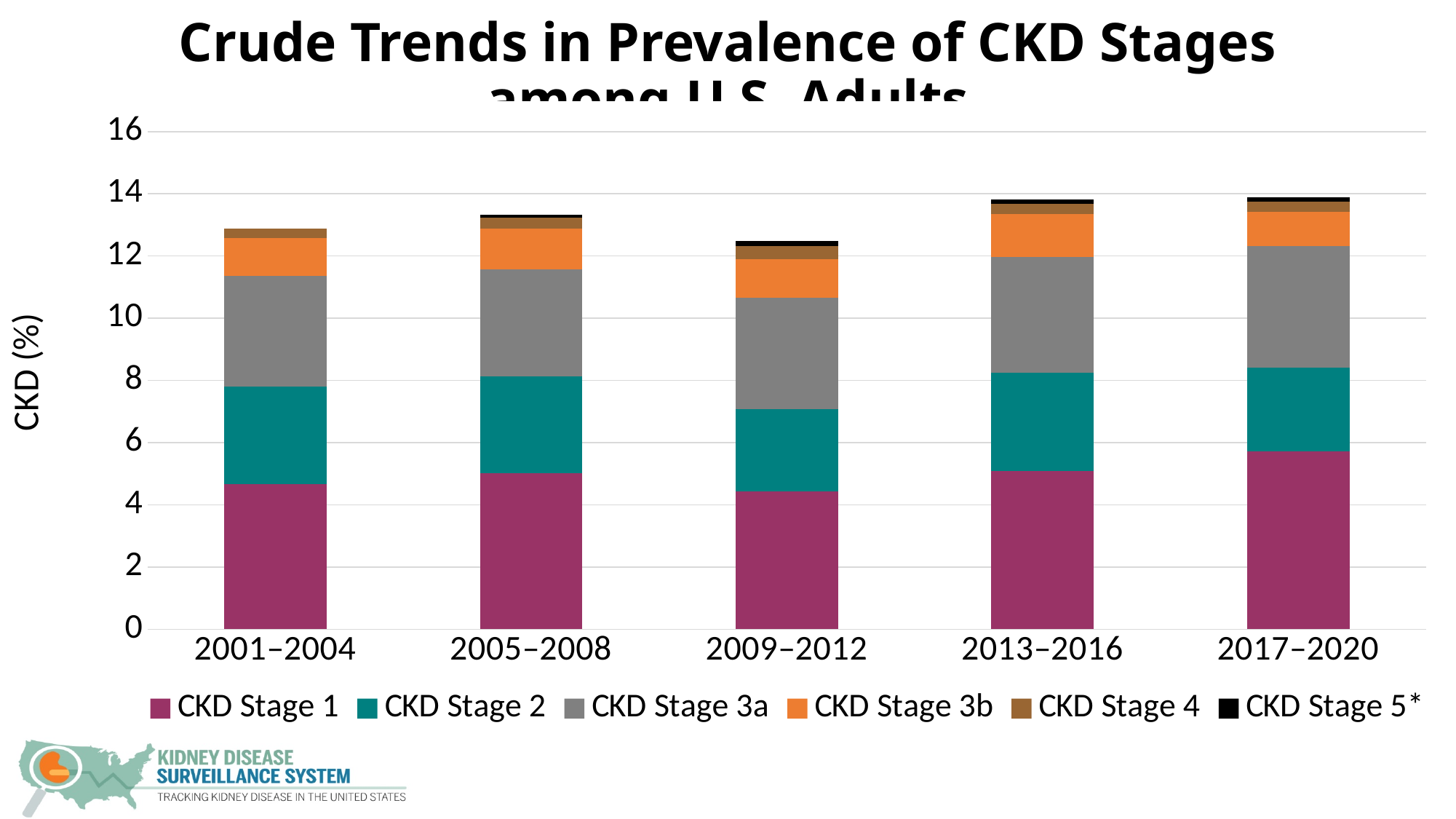
Which has the larger total CKD prevalence, 2013–2016 or 2009–2012? 2013–2016 What kind of chart is shown on the slide? Stacked bar chart Is the total CKD prevalence for 2009–2012 greater or less than 12? greater How many series does the legend list? 6 Is the CKD Stage 1 value for 2009–2012 greater or less than 5? less Which time period has the lowest total CKD prevalence? 2009–2012 What is the label on the y axis? CKD (%) Is the CKD Stage 1 value for 2017–2020 greater or less than 5? greater How many time periods (categories) are shown on the x axis? 5 Which has the larger CKD Stage 1 value, 2017–2020 or 2001–2004? 2017–2020 Which legend entry is marked with an asterisk? CKD Stage 5*